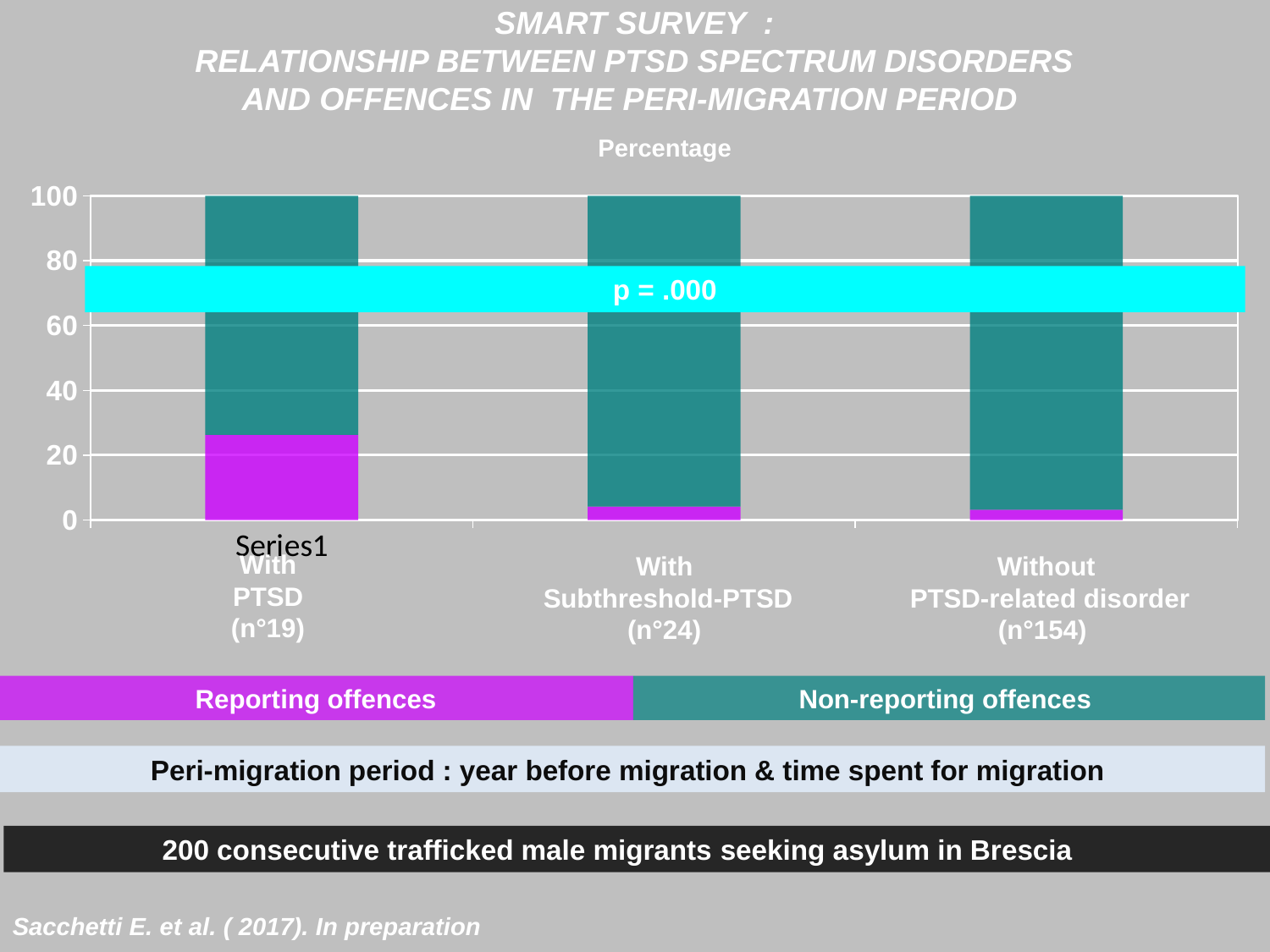
How many series does the legend list? 2 Which category has the highest value for Reporting offences? With PTSD (n°19) What is the title of the chart's value axis label shown above the plot? Percentage What kind of chart is shown on the slide? Stacked bar chart How many categories are shown on the x axis of the chart? 3 Is the Reporting offences value for With Subthreshold-PTSD (n°24) greater or less than 20? less Is the Reporting offences value for With PTSD (n°19) greater or less than 20? greater Is the Non-reporting offences value for With PTSD (n°19) greater or less than 60? greater Which is larger, the Reporting offences value for With PTSD (n°19) or for Without PTSD-related disorder (n°154)? With PTSD (n°19) What is the total height of the stacked bar for With Subthreshold-PTSD (n°24)? 100 What p value is printed across the chart? p = .000